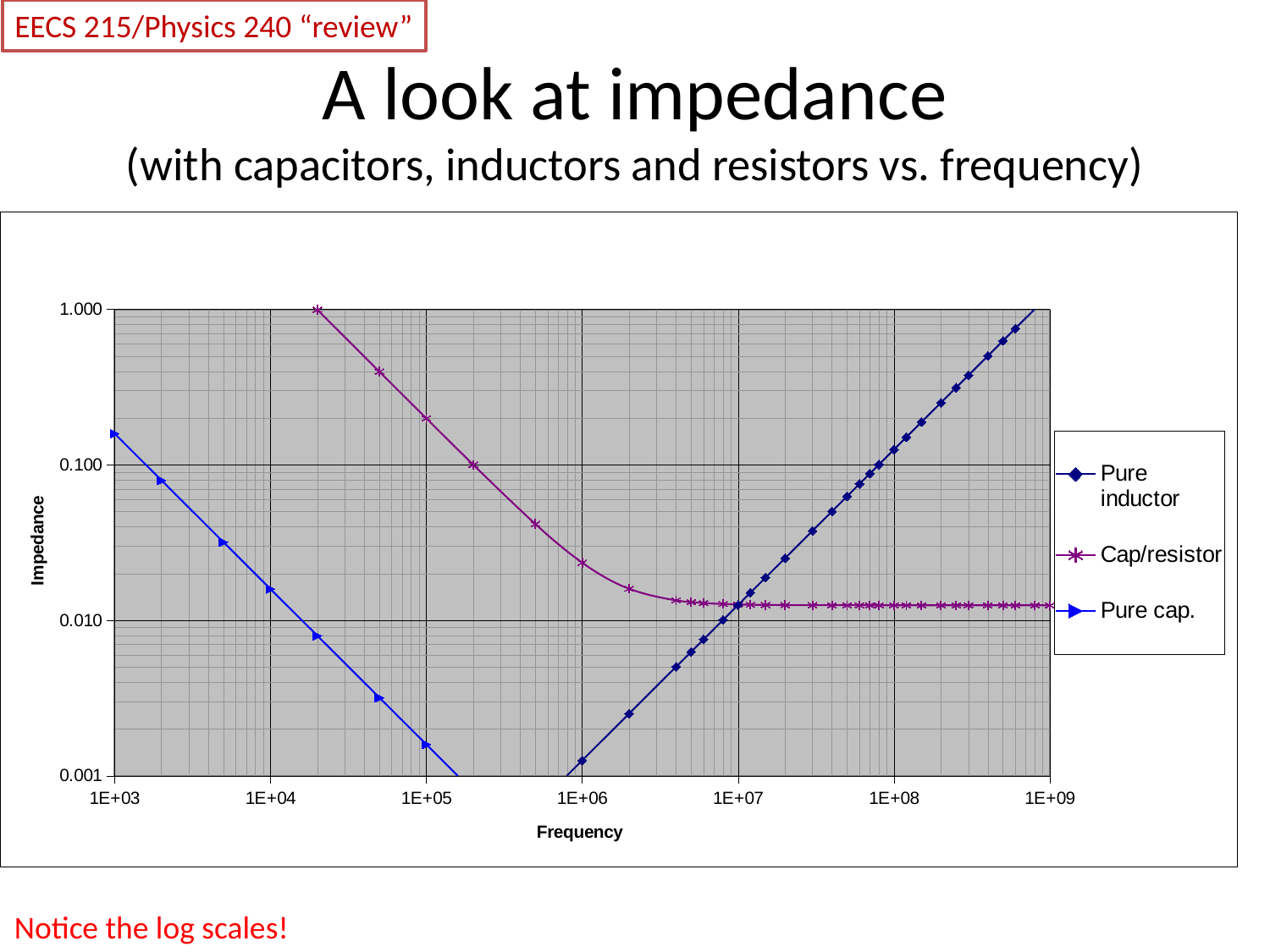
Is the Cap/resistor impedance at a frequency of 1E+09 greater or less than 0.010? greater At a frequency of 1E+08, which series has the higher impedance, Pure inductor or Cap/resistor? Pure inductor Does the Pure inductor series rise or fall as frequency increases? rise At a frequency of 1E+04, which series has the higher impedance, Pure cap. or Cap/resistor? Cap/resistor What are the three series named in the legend? Pure inductor, Cap/resistor, Pure cap. Is the Cap/resistor impedance at a frequency of 1E+09 greater or less than 0.100? less How many series does the chart's legend list? 3 Is the Pure cap. impedance at a frequency of 1E+04 greater or less than 0.010? greater Does the Pure cap. series rise or fall as frequency increases? fall What is the title of the chart's x axis? Frequency What kind of chart is shown on the slide? line chart